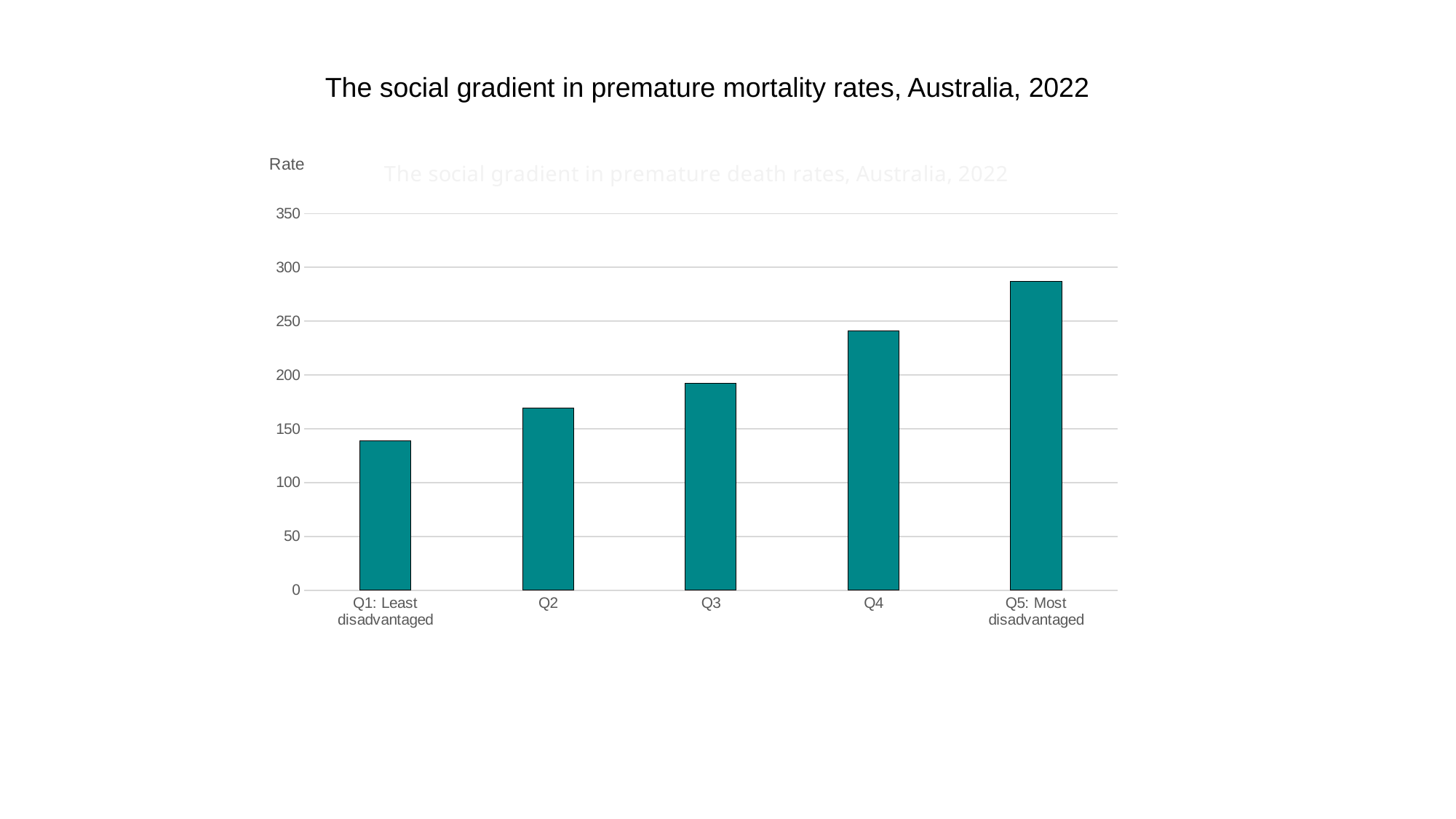
What kind of chart is shown on the slide? Bar chart Which is larger, the rate for Q4 or the rate for Q2? Q4 Is the value for Q5: Most disadvantaged greater or less than 250? greater Which is larger, the rate for Q3 or the rate for Q5: Most disadvantaged? Q5: Most disadvantaged How many categories (quintiles) are plotted on the chart? 5 Which category has the highest premature mortality rate? Q5: Most disadvantaged Is the value for Q4 greater or less than 200? greater What is the title of the chart? The social gradient in premature mortality rates, Australia, 2022 Is the value for Q2 greater or less than 150? greater Do the values rise or fall moving from Q1 to Q5 along the x axis? Rise Which category has the lowest premature mortality rate? Q1: Least disadvantaged